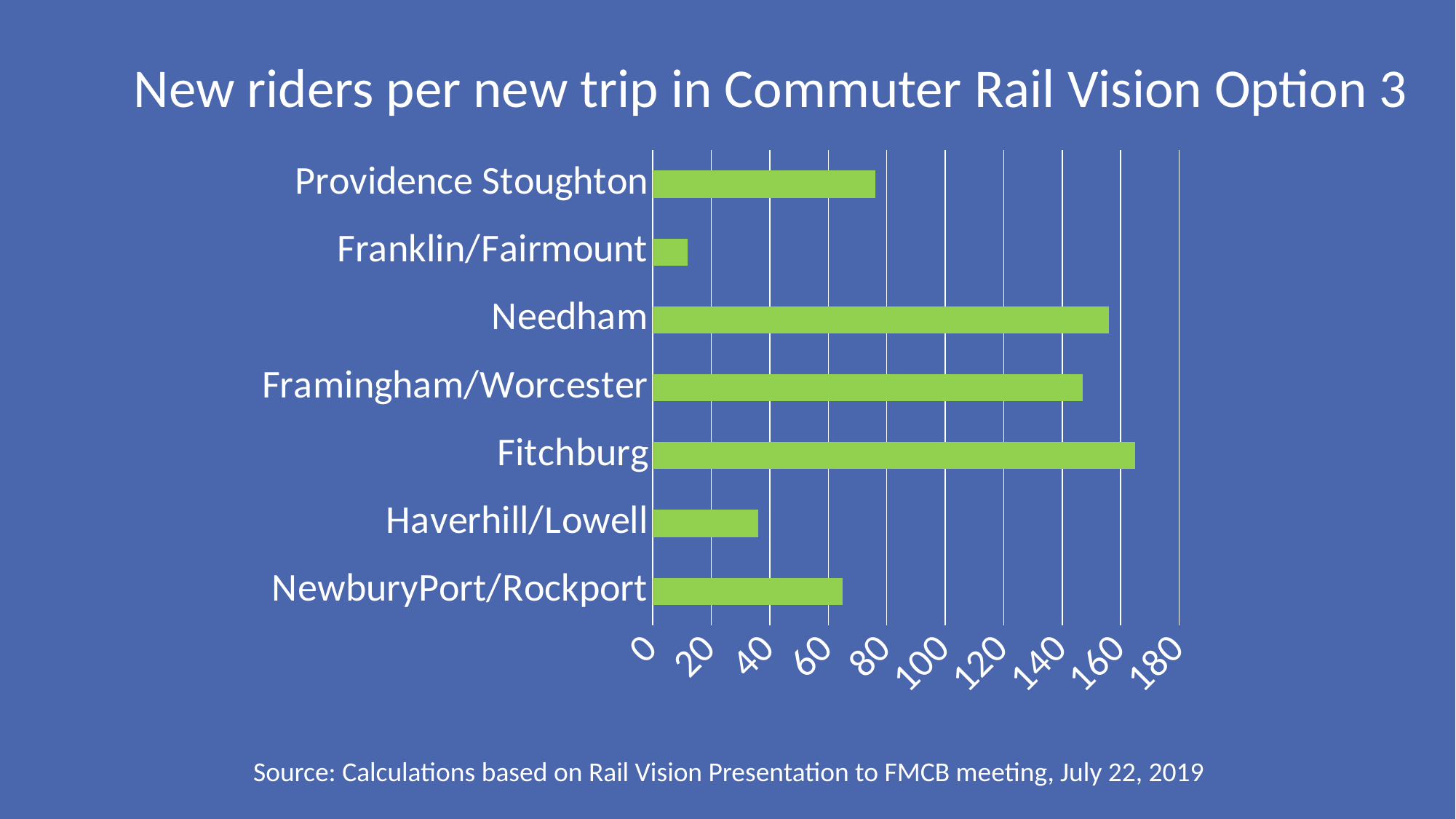
How many rail lines are shown in the chart? 7 Is the value for Haverhill/Lowell greater or less than 60? less Is the value for Franklin/Fairmount greater or less than 20? less What is the title of the chart? New riders per new trip in Commuter Rail Vision Option 3 Which rail line has the highest number of new riders per new trip? Fitchburg Which has more new riders per new trip, Providence Stoughton or NewburyPort/Rockport? Providence Stoughton Is the value for Needham greater or less than 140? greater Which rail line has the lowest number of new riders per new trip? Franklin/Fairmount What kind of chart is shown on the slide? bar chart Which has more new riders per new trip, Needham or Framingham/Worcester? Needham